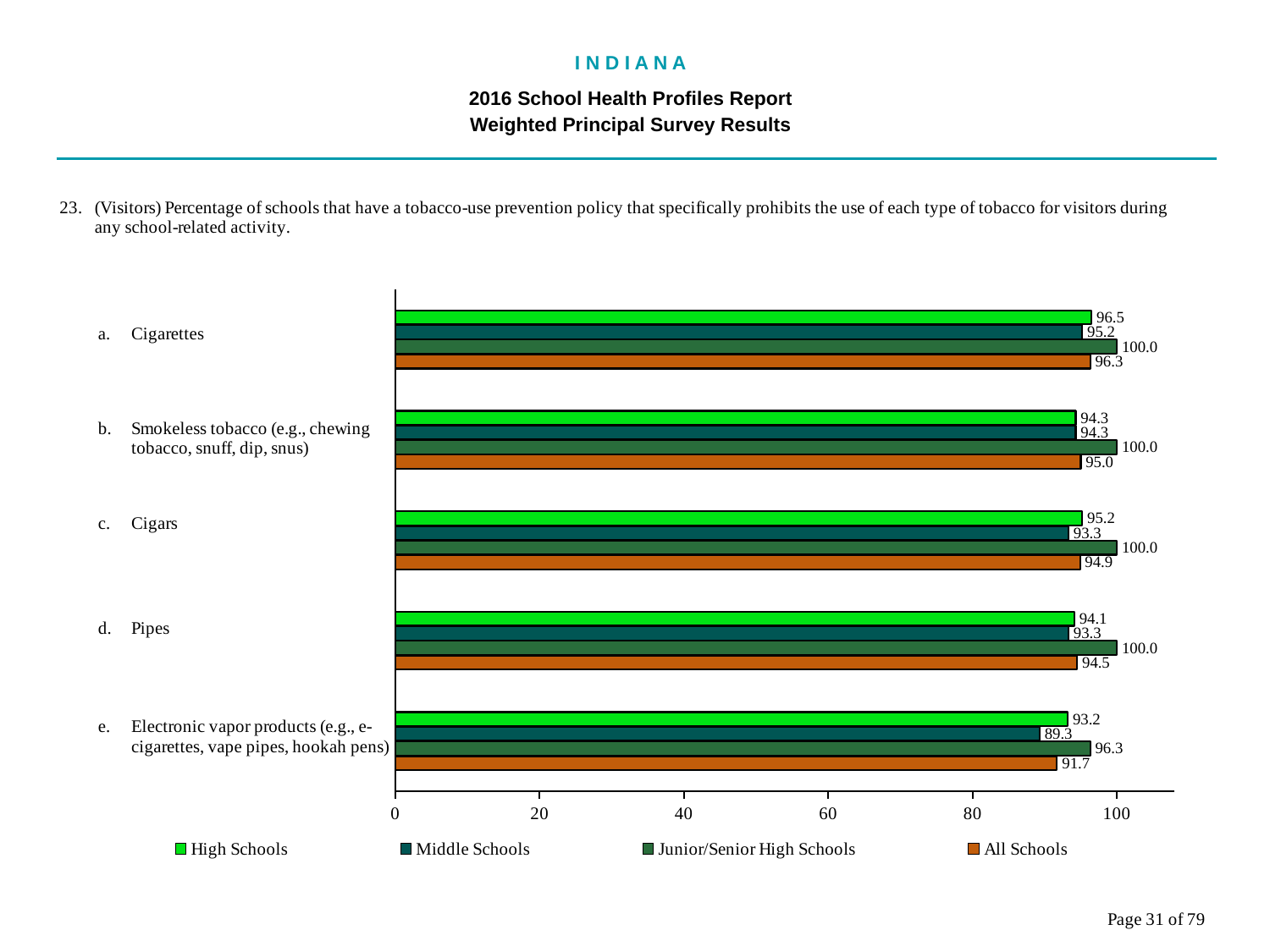
How many series does the legend list? 4 Which category has the lowest value for Middle Schools? Electronic vapor products What is the value for Middle Schools for Electronic vapor products? 89.3 What is the value for All Schools for Cigars? 94.9 Which series is shown in orange in the legend? All Schools What is the difference between the Junior/Senior High Schools and Middle Schools values for Electronic vapor products? 7.0 Which is larger for Smokeless tobacco: the High Schools value or the All Schools value? All Schools How many categories are shown on the chart? 5 What kind of chart is shown on the slide? bar chart What is the value for High Schools for Cigarettes? 96.5 Which category has the highest value for All Schools? Cigarettes What is the value for Junior/Senior High Schools for Pipes? 100.0